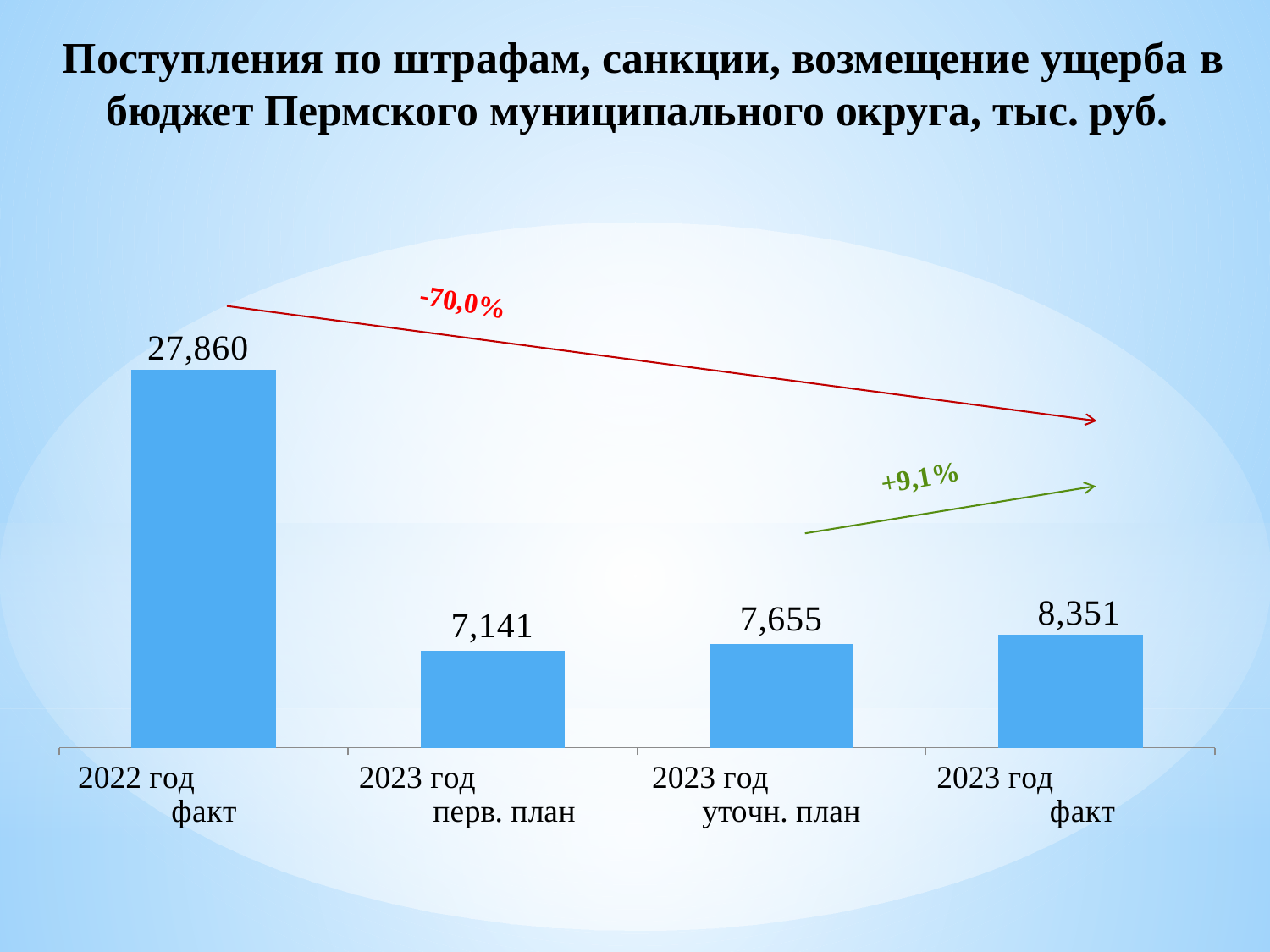
What is the value for 2022 год факт? 27,860 What is the value for 2023 год перв. план? 7,141 Which category has the highest value? 2022 год факт Which category has the lowest value? 2023 год перв. план What is the difference between the values for 2023 год факт and 2023 год уточн. план? 696 What kind of chart is shown on the slide? bar chart What is the value for 2023 год факт? 8,351 What is the difference between the values for 2022 год факт and 2023 год факт? 19,509 How many categories are shown on the chart? 4 Which is larger, the value for 2023 год уточн. план or 2023 год перв. план? 2023 год уточн. план What percentage change is shown by the red arrow from 2022 год факт to 2023 год факт? -70,0% What is the value for 2023 год уточн. план? 7,655